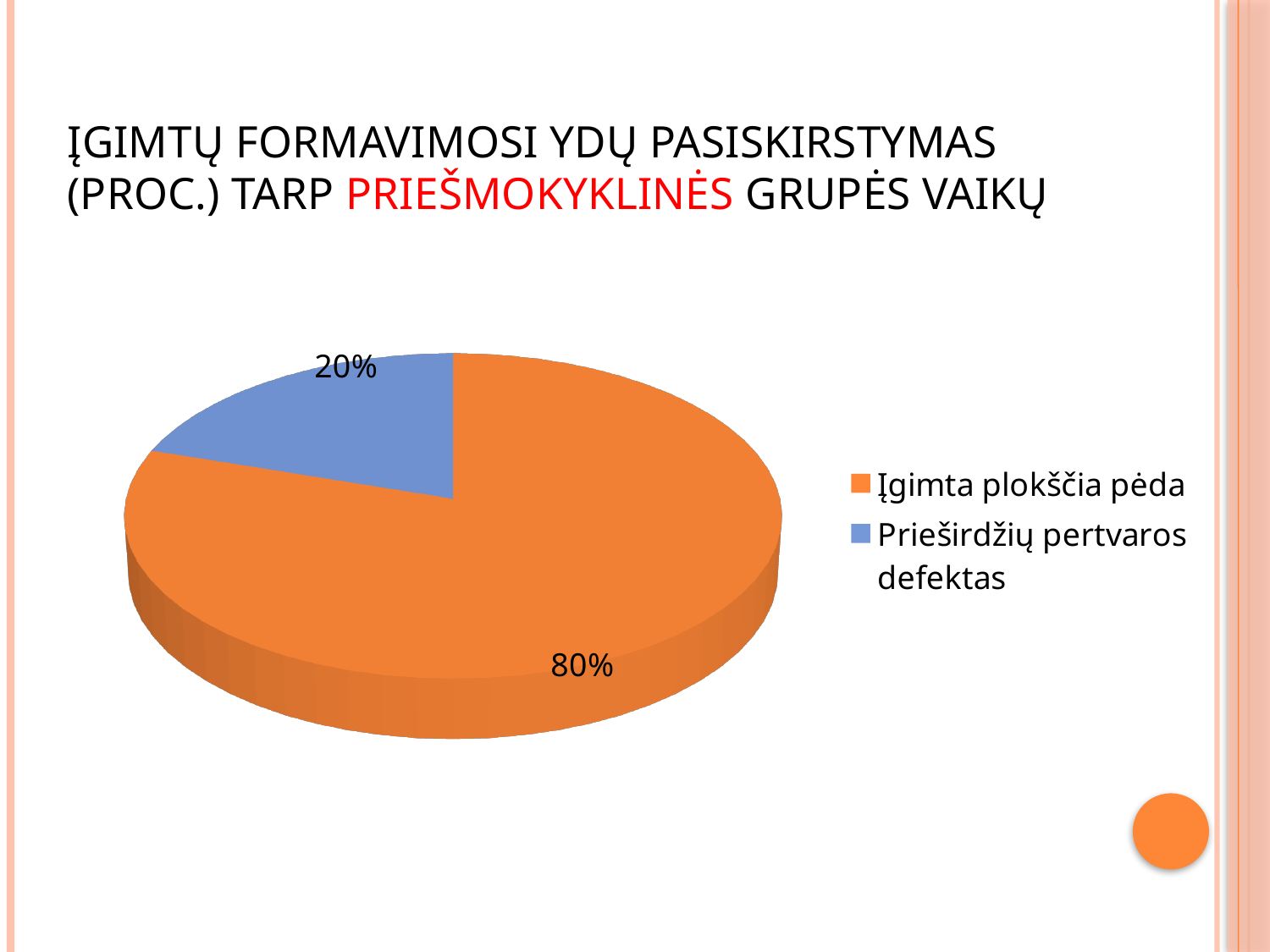
Which is larger: the slice for "Įgimta plokščia pėda" or the slice for "Prieširdžių pertvaros defektas"? Įgimta plokščia pėda Which category has the smallest slice of the pie? Prieširdžių pertvaros defektas Which category has the largest slice of the pie? Įgimta plokščia pėda What colour is the slice for "Prieširdžių pertvaros defektas"? blue How many entries does the legend list? 2 What kind of chart is shown on the slide? pie chart What is the difference in percentage points between the "Įgimta plokščia pėda" slice and the "Prieširdžių pertvaros defektas" slice? 60 How many slices does the pie chart have? 2 What share of the pie does "Prieširdžių pertvaros defektas" take? 20% What colour is the slice for "Įgimta plokščia pėda"? orange What share of the pie does "Įgimta plokščia pėda" take? 80%